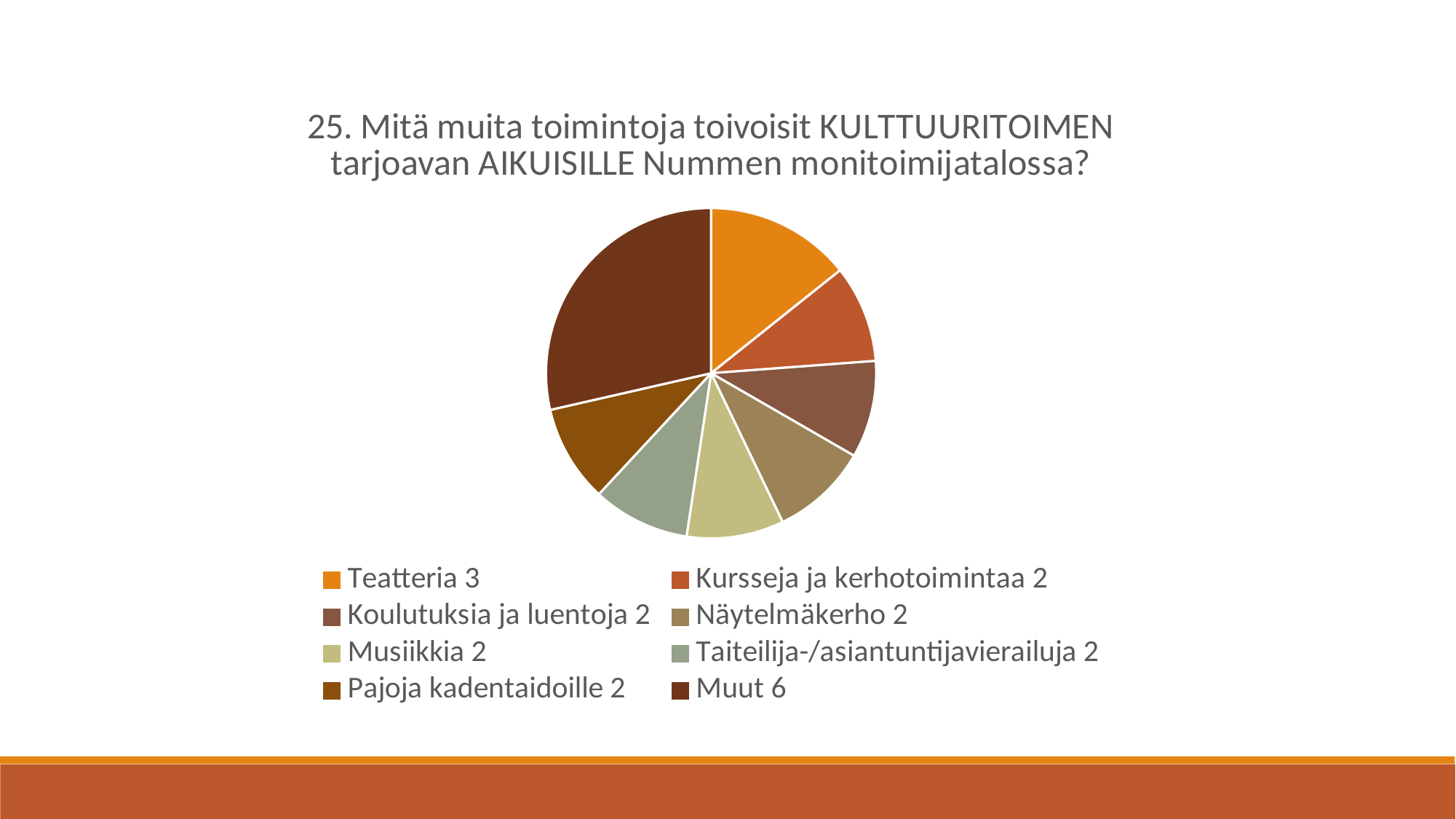
Which category has the largest slice of the pie? Muut What colour is the slice for Teatteria? orange What is the value for Kursseja ja kerhotoimintaa? 2 What is the difference between the value for Muut and the value for Teatteria? 3 What is the total of all the values shown in the legend? 21 What is the value for Muut? 6 What is the difference between the value for Teatteria and the value for Näytelmäkerho? 1 How many categories does the pie chart have? 8 What is the value for Teatteria? 3 What kind of chart is shown on the slide? pie chart What is the value for Pajoja kadentaidoille? 2 Which is larger, the value for Teatteria or the value for Musiikkia? Teatteria